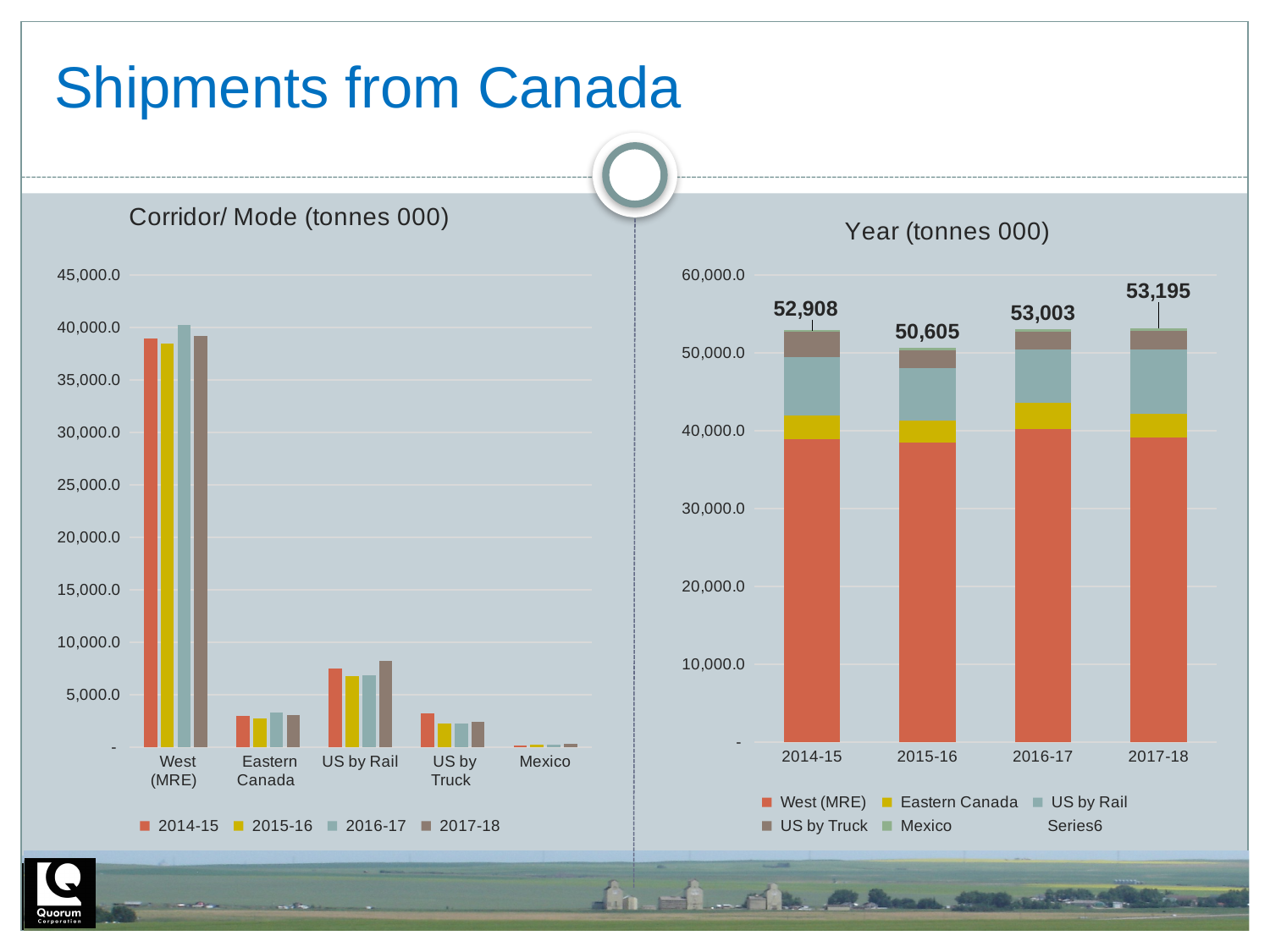
On the 'Year (tonnes 000)' chart, how many entries does the legend list? 6 On the 'Year (tonnes 000)' chart, which total is larger, 2014-15 or 2016-17? 2016-17 What kind of chart is the 'Year (tonnes 000)' chart? Stacked bar chart On the 'Year (tonnes 000)' chart, what is the total for 2015-16? 50,605 On the 'Year (tonnes 000)' chart, which year has the highest total? 2017-18 On the 'Year (tonnes 000)' chart, which year has the lowest total? 2015-16 On the 'Year (tonnes 000)' chart, what is the total for 2014-15? 52,908 On the 'Corridor/ Mode (tonnes 000)' chart, how many series does the legend list? 4 On the 'Corridor/ Mode (tonnes 000)' chart, is the value for US by Rail in 2017-18 greater or less than 5,000.0? greater On the 'Year (tonnes 000)' chart, what is the difference between the 2014-15 total and the 2015-16 total? 2,303 On the 'Year (tonnes 000)' chart, what is the difference between the 2017-18 total and the 2016-17 total? 192 On the 'Corridor/ Mode (tonnes 000)' chart, how many corridor/mode categories are shown on the x axis? 5